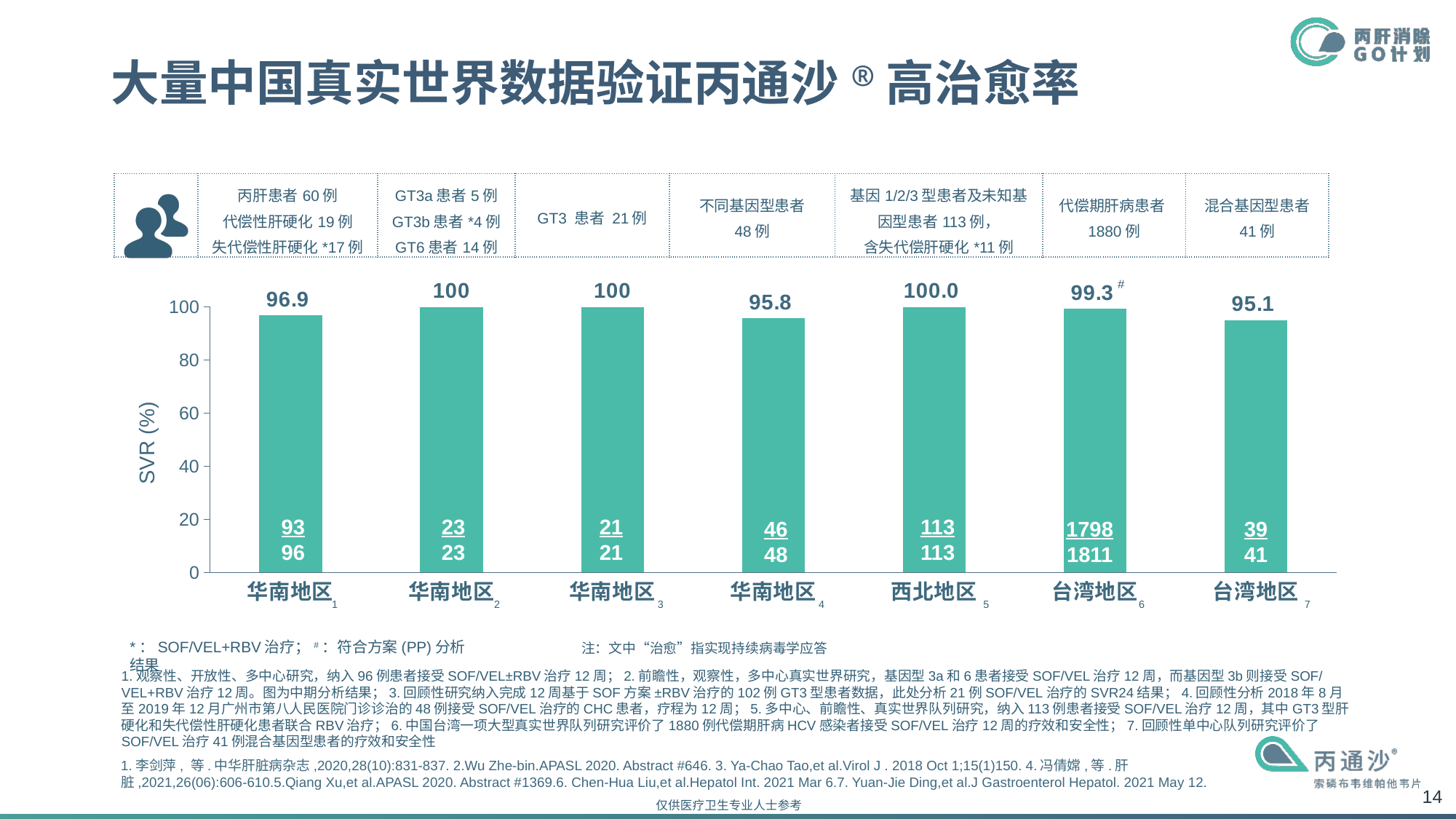
What is the SVR (%) value shown for the first bar, 华南地区 (1)? 96.9 How many bars are plotted in the chart? 7 What is the SVR (%) value shown for the 西北地区 (5) bar? 100.0 How many bars reach an SVR of 100? 3 Which bar has the lowest SVR (%) value? 台湾地区 (7) What is the SVR (%) value shown for the 台湾地区 (6) bar? 99.3 What is the difference in SVR (%) between 台湾地区 (6) and 台湾地区 (7)? 4.2 What fraction is printed inside the 华南地区 (4) bar? 46/48 What is the label of the y axis? SVR (%) What fraction is printed inside the 台湾地区 (6) bar? 1798/1811 What type of chart is shown on the slide? Bar chart Which has a higher SVR (%): 华南地区 (1) or 华南地区 (4)? 华南地区 (1)